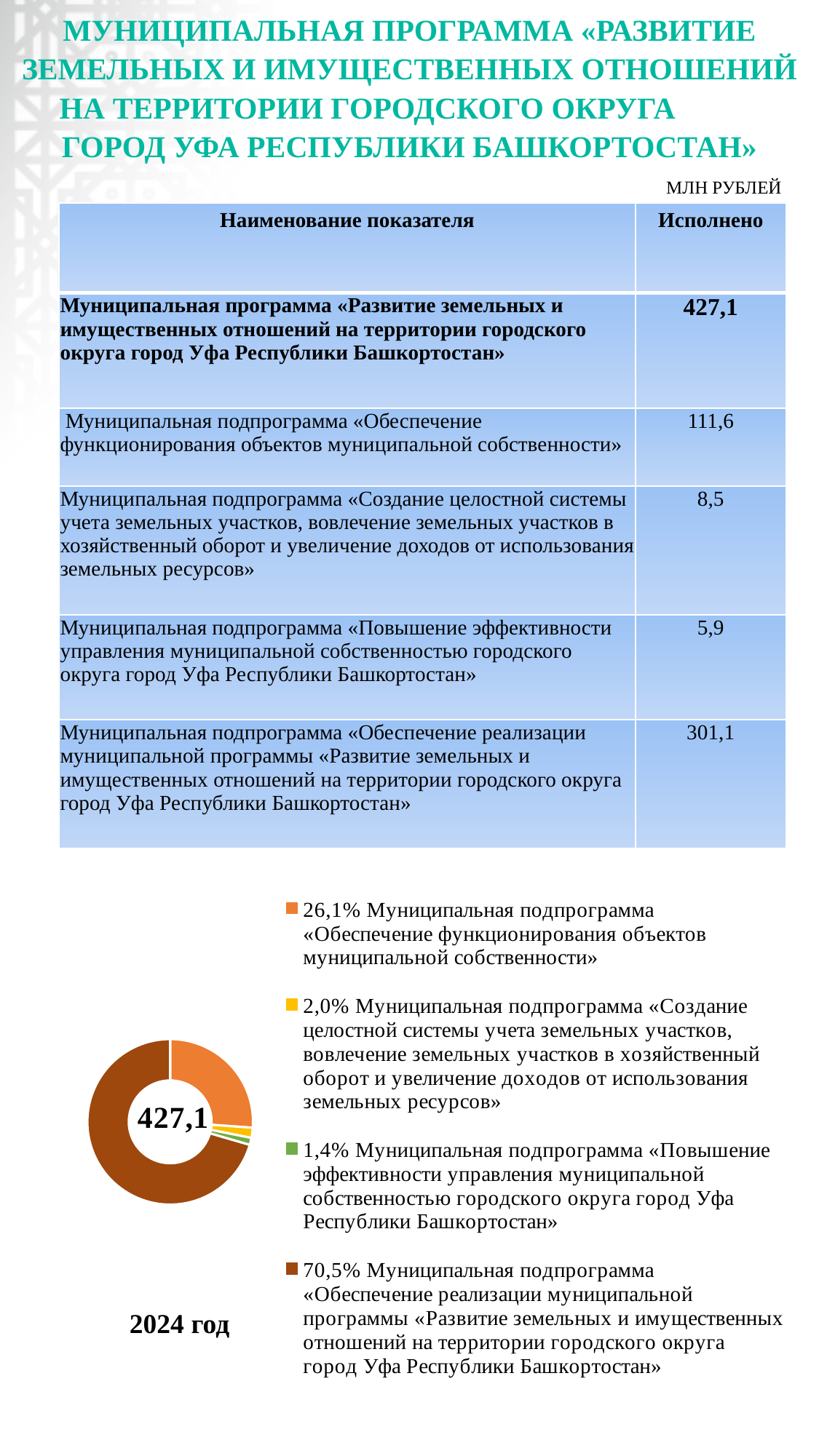
Which subprogram has the largest slice in the doughnut chart? Муниципальная подпрограмма «Обеспечение реализации муниципальной программы «Развитие земельных и имущественных отношений на территории городского округа город Уфа Республики Башкортостан» What share of the doughnut chart does the subprogram «Повышение эффективности управления муниципальной собственностью...» have? 1,4% What kind of chart is shown at the bottom of the slide? doughnut (pie) chart How many slices does the doughnut chart have? 4 What value is printed in the centre of the doughnut chart? 427,1 Which subprogram has the smallest slice in the doughnut chart? Муниципальная подпрограмма «Повышение эффективности управления муниципальной собственностью городского округа город Уфа Республики Башкортостан» What share of the doughnut chart does the subprogram «Создание целостной системы учета земельных участков...» have? 2,0% How many entries does the legend of the doughnut chart list? 4 What year label is shown below the doughnut chart? 2024 год What share of the doughnut chart does the subprogram «Обеспечение реализации муниципальной программы...» have? 70,5% In the doughnut chart, which slice is larger: «Обеспечение функционирования объектов муниципальной собственности» or «Создание целостной системы учета земельных участков...»? «Обеспечение функционирования объектов муниципальной собственности»